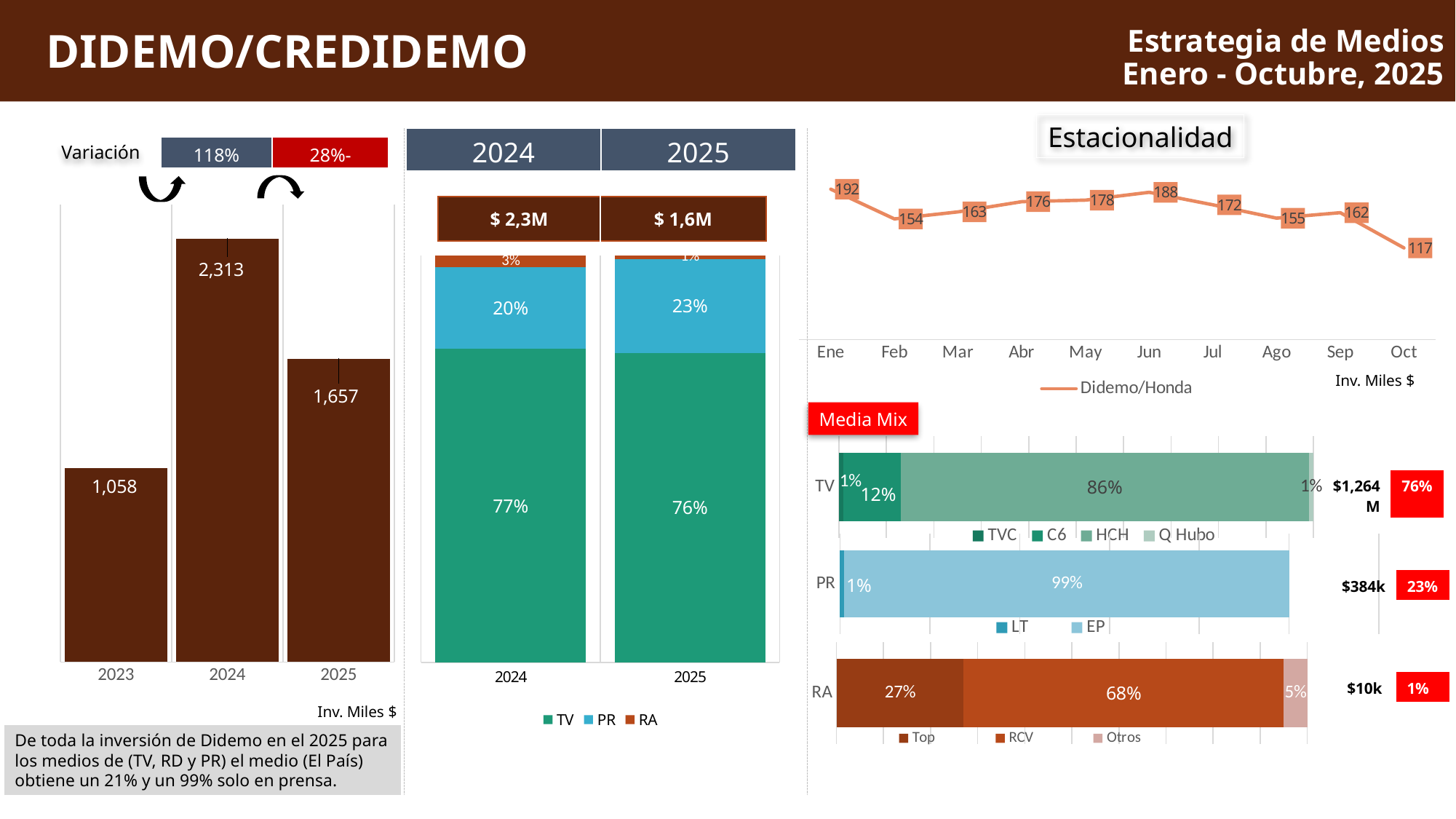
In the Estacionalidad line chart, which month has the lowest value? Oct In the Estacionalidad line chart, what kind of chart is it? Line chart In the stacked bar chart comparing 2024 and 2025 by medium, what share does PR have in 2025? 23% In the Media Mix chart, what share does RCV have within the RA bar? 68% In the Estacionalidad line chart, what is the value for Jun? 188 In the left bar chart of investment by year, which year has the lowest value? 2023 In the left bar chart of investment by year, what is the value for 2024? 2,313 In the stacked bar chart comparing 2024 and 2025 by medium, what share does TV have in 2024? 77% In the stacked bar chart comparing 2024 and 2025 by medium, how many series does the legend list? 3 In the left bar chart of investment by year, how many years are shown? 3 In the Estacionalidad line chart, what is the difference between the Ene and Feb values? 38 In the left bar chart of investment by year, what is the difference between the 2024 and 2025 values? 656